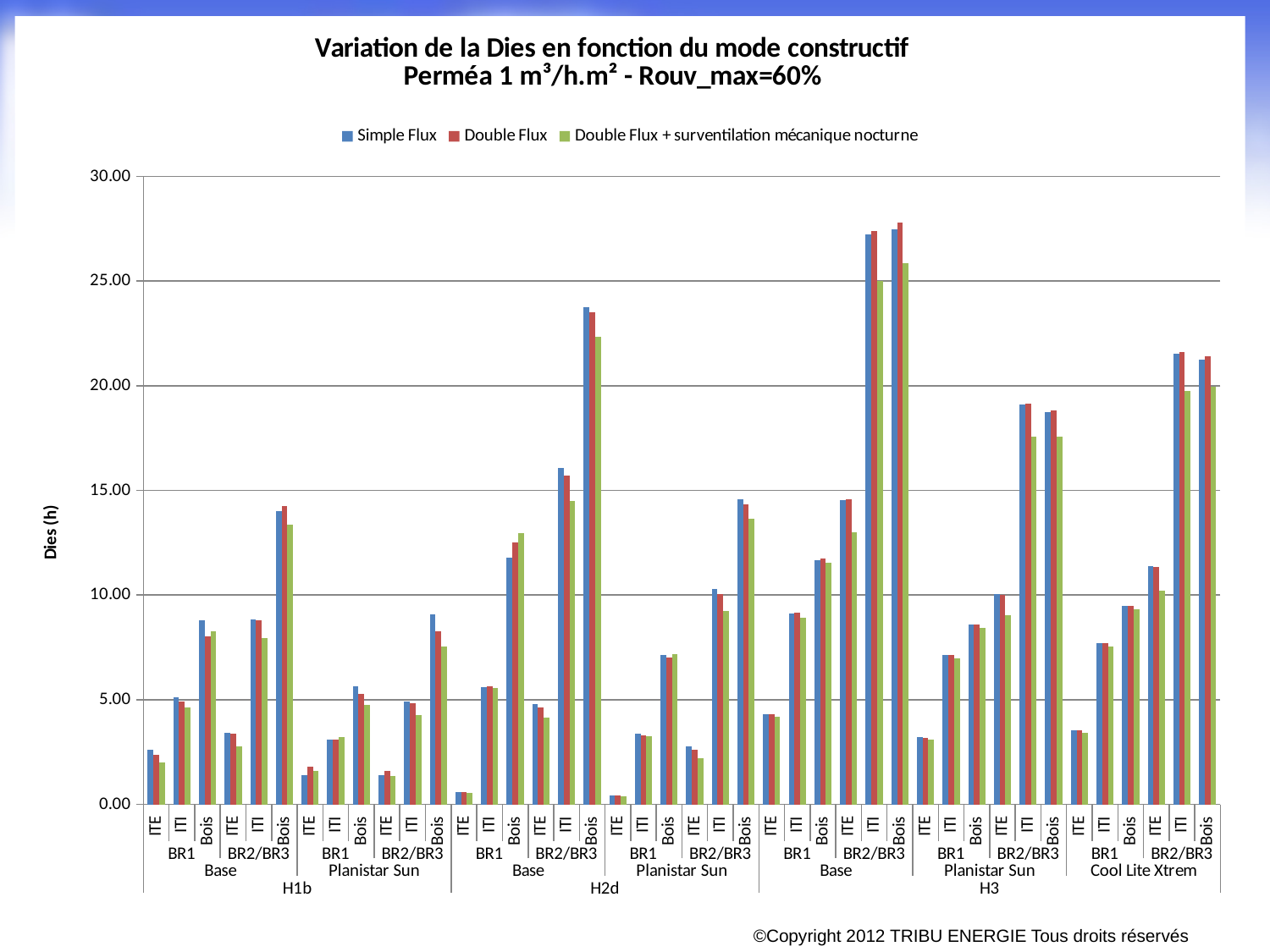
What is the label of the vertical axis? Dies (h) Within the H3 Base group, do the Simple Flux values generally rise or fall from BR1 ITE to BR2/BR3 Bois? Rise How many series does the legend list? 3 Which series is shown in green in the legend? Double Flux + surventilation mécanique nocturne For H3, Base, BR2/BR3, ITI, which is larger: the Simple Flux value or the Double Flux + surventilation mécanique nocturne value? Simple Flux How many glazing groups are shown under H3? 3 Is the Simple Flux value for H2d, Base, BR2/BR3, Bois greater or less than 20.00? greater Which climate zone contains the tallest bars on the chart? H3 Is the Simple Flux value for H3, Planistar Sun, BR2/BR3, ITI greater or less than 20.00? less How many climate zones (top-level groups) are shown along the x axis? 3 Is the Simple Flux value for H1b, Base, BR2/BR3, Bois greater or less than 15.00? less What kind of chart is shown on the slide? Bar chart